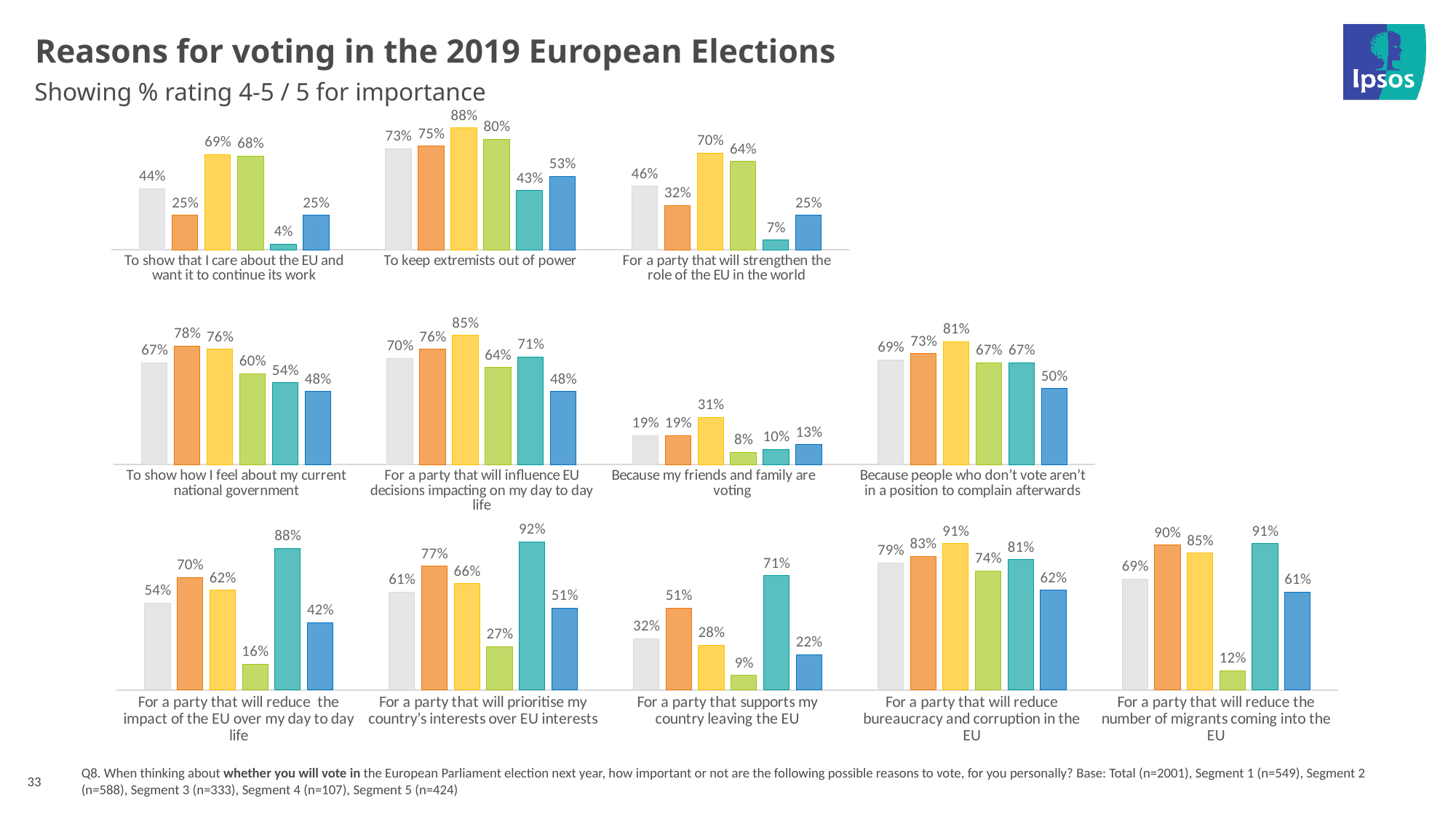
How many separate bar charts are shown on the slide? 3 In the chart 'To show how I feel about my current national government', which is larger: the orange bar or the blue bar? The orange bar (78%) In the chart 'To show that I care about the EU and want it to continue its work', which bar has the lowest value? The teal bar (4%) In the chart 'For a party that will reduce bureaucracy and corruption in the EU', what value is shown for the blue bar? 62% What is the title of the slide? Reasons for voting in the 2019 European Elections How many bars are shown in the chart 'For a party that will strengthen the role of the EU in the world'? 6 In the chart 'For a party that will reduce the number of migrants coming into the EU', what is the difference between the orange bar and the green bar? 78 percentage points What type of chart is used on this slide? Bar chart In the chart 'For a party that will prioritise my country's interests over EU interests', which bar has the highest value? The teal bar (92%) In the chart 'Because my friends and family are voting', what value is shown for the green bar? 8% In the chart 'For a party that supports my country leaving the EU', what value is shown for the teal bar? 71% In the chart 'To keep extremists out of power', what value is shown for the yellow bar? 88%